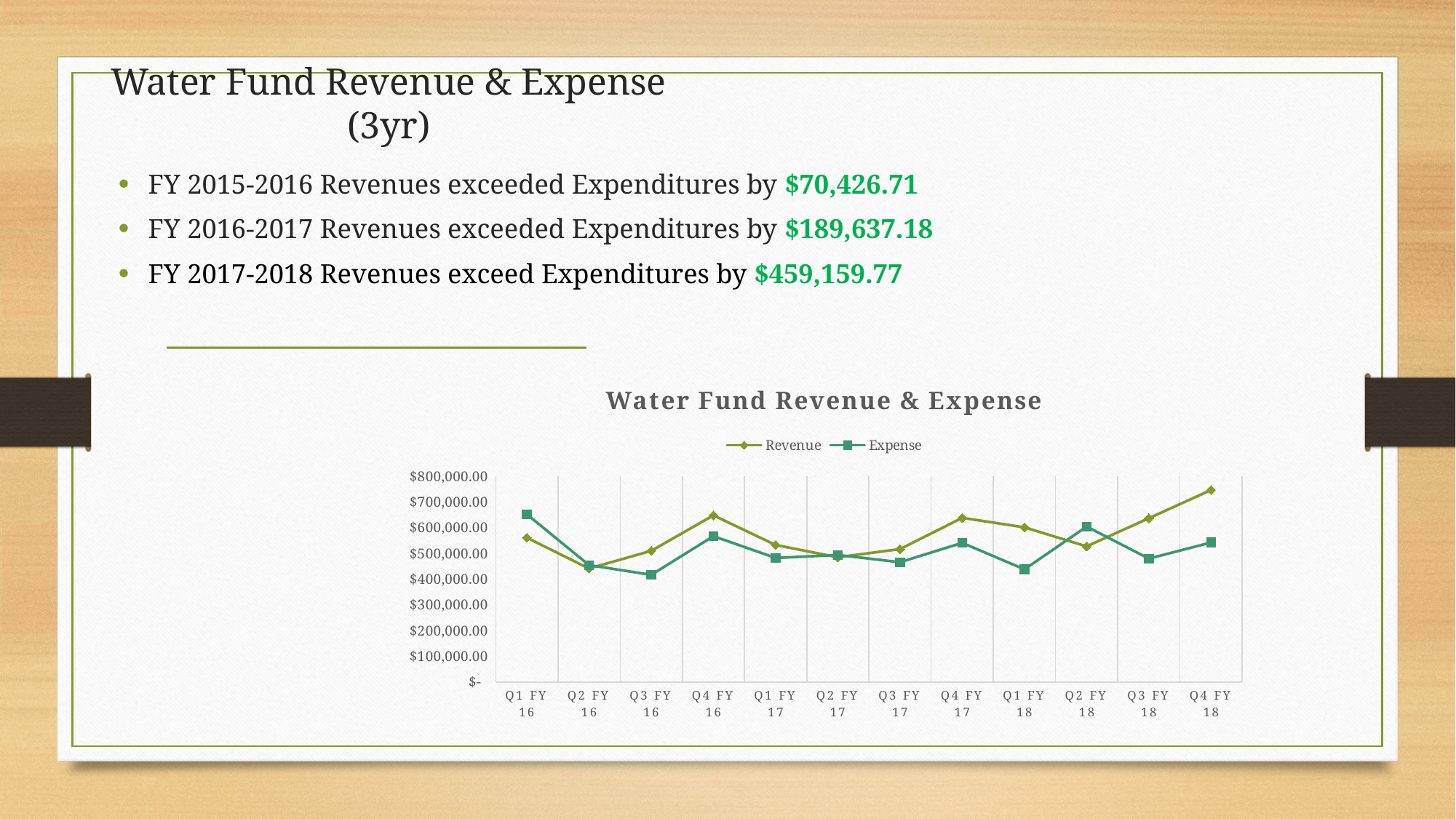
How many series does the chart legend list? 2 In Q1 FY 18, which is larger, Revenue or Expense? Revenue Is the Expense value for Q1 FY 16 greater or less than $600,000.00? greater Is the Revenue value for Q4 FY 18 greater or less than $700,000.00? greater In which quarter is Revenue lowest? Q2 FY 16 Does Revenue rise or fall from Q2 FY 16 to Q4 FY 16? rise What kind of chart is shown on the slide? line chart In which quarter is Expense highest? Q1 FY 16 In which quarter is Revenue highest? Q4 FY 18 In Q1 FY 16, which is larger, Revenue or Expense? Expense Is the Expense value for Q3 FY 16 greater or less than $500,000.00? less How many quarters are plotted along the x axis of the chart? 12